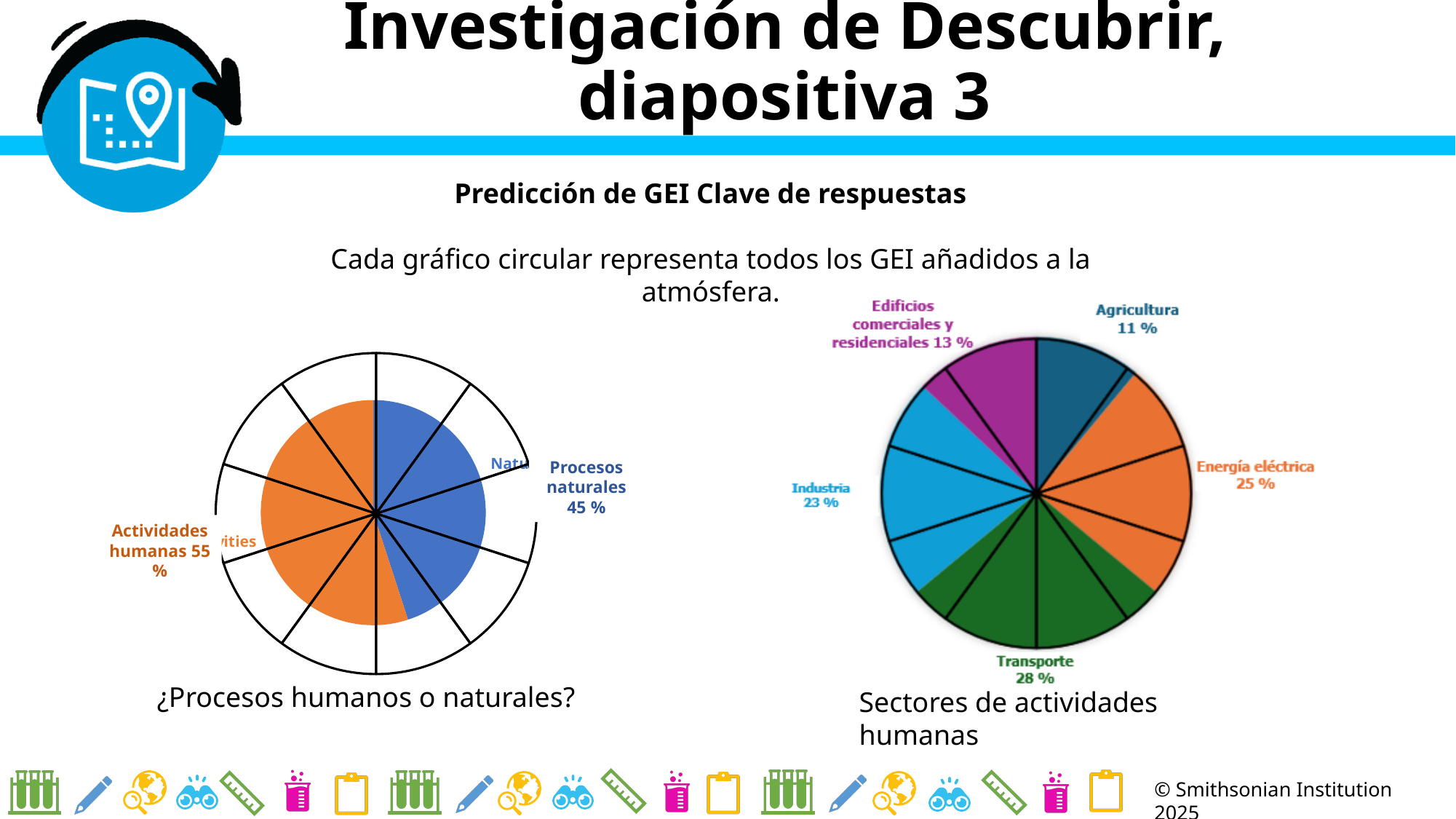
In the Sectores de actividades humanas pie chart, what share is shown for Agricultura? 11 % In the Sectores de actividades humanas pie chart, which sector has the smallest share? Agricultura In the Sectores de actividades humanas pie chart, what share is shown for Transporte? 28 % In the Sectores de actividades humanas pie chart, what is the difference between the Energía eléctrica and Industria shares? 2 % In the left pie chart (¿Procesos humanos o naturales?), which slice is larger, Actividades humanas or Procesos naturales? Actividades humanas In the left pie chart (¿Procesos humanos o naturales?), what is the difference between the Actividades humanas and Procesos naturales shares? 10 % What kind of chart is the chart titled Sectores de actividades humanas? Pie chart In the Sectores de actividades humanas pie chart, which sector has the largest share? Transporte In the left pie chart (¿Procesos humanos o naturales?), what share is shown for Actividades humanas? 55 % In the left pie chart (¿Procesos humanos o naturales?), what share is shown for Procesos naturales? 45 % In the Sectores de actividades humanas pie chart, how many sectors are shown? 5 In the Sectores de actividades humanas pie chart, what share is shown for Edificios comerciales y residenciales? 13 %